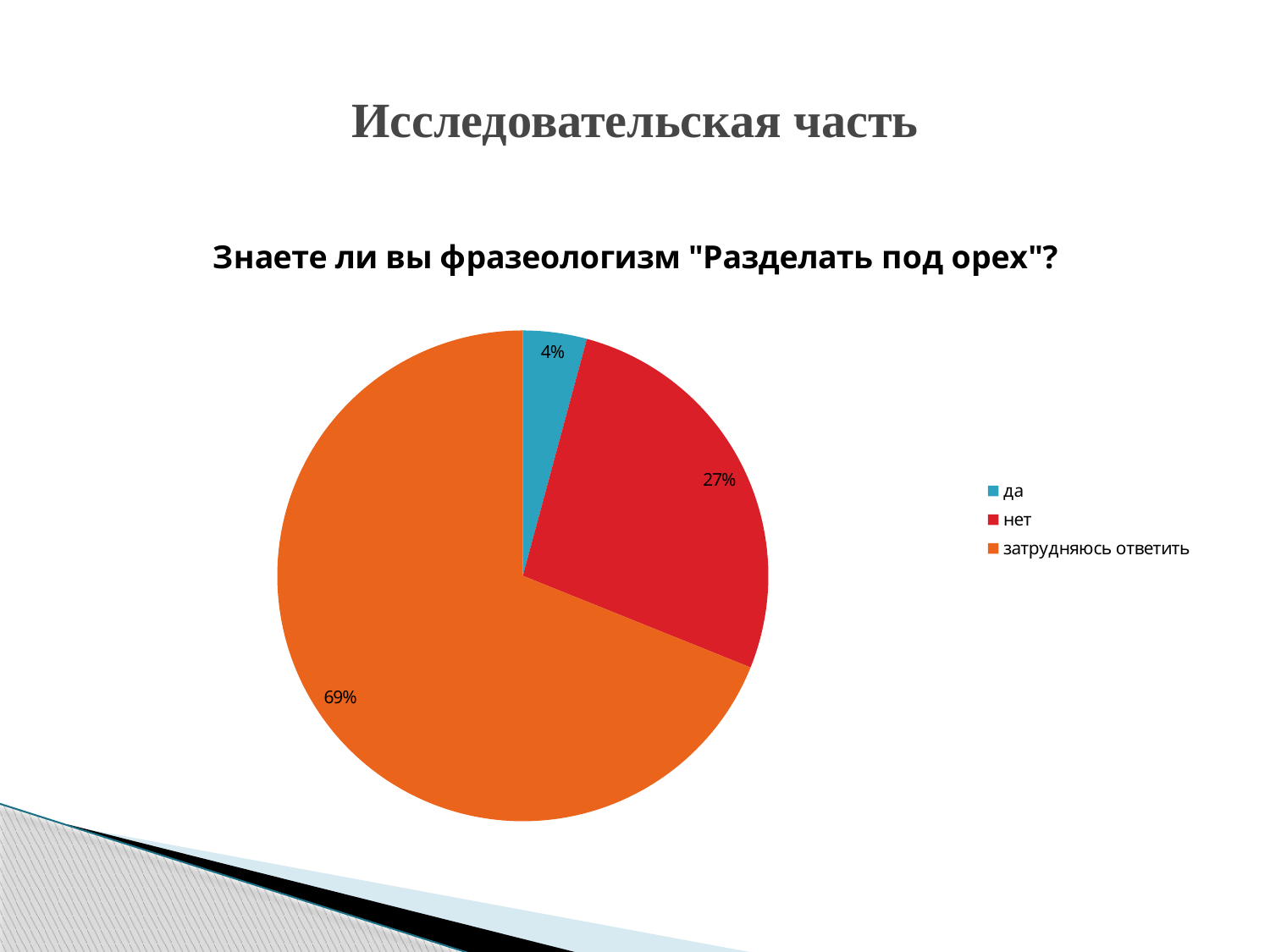
What is the value for "да"? 4% What is the title of the chart? Знаете ли вы фразеологизм "Разделать под орех"? What colour is the slice for "нет"? red How many categories does the pie chart have? 3 What is the difference between the shares for "нет" and "да"? 23% What is the difference between the shares for "затрудняюсь ответить" and "нет"? 42% What kind of chart is shown on the slide? pie chart Which category has the smallest share of the pie? да Which is larger, the share for "нет" or the share for "да"? нет What is the value for "нет"? 27% Which category has the largest share of the pie? затрудняюсь ответить What is the value for "затрудняюсь ответить"? 69%